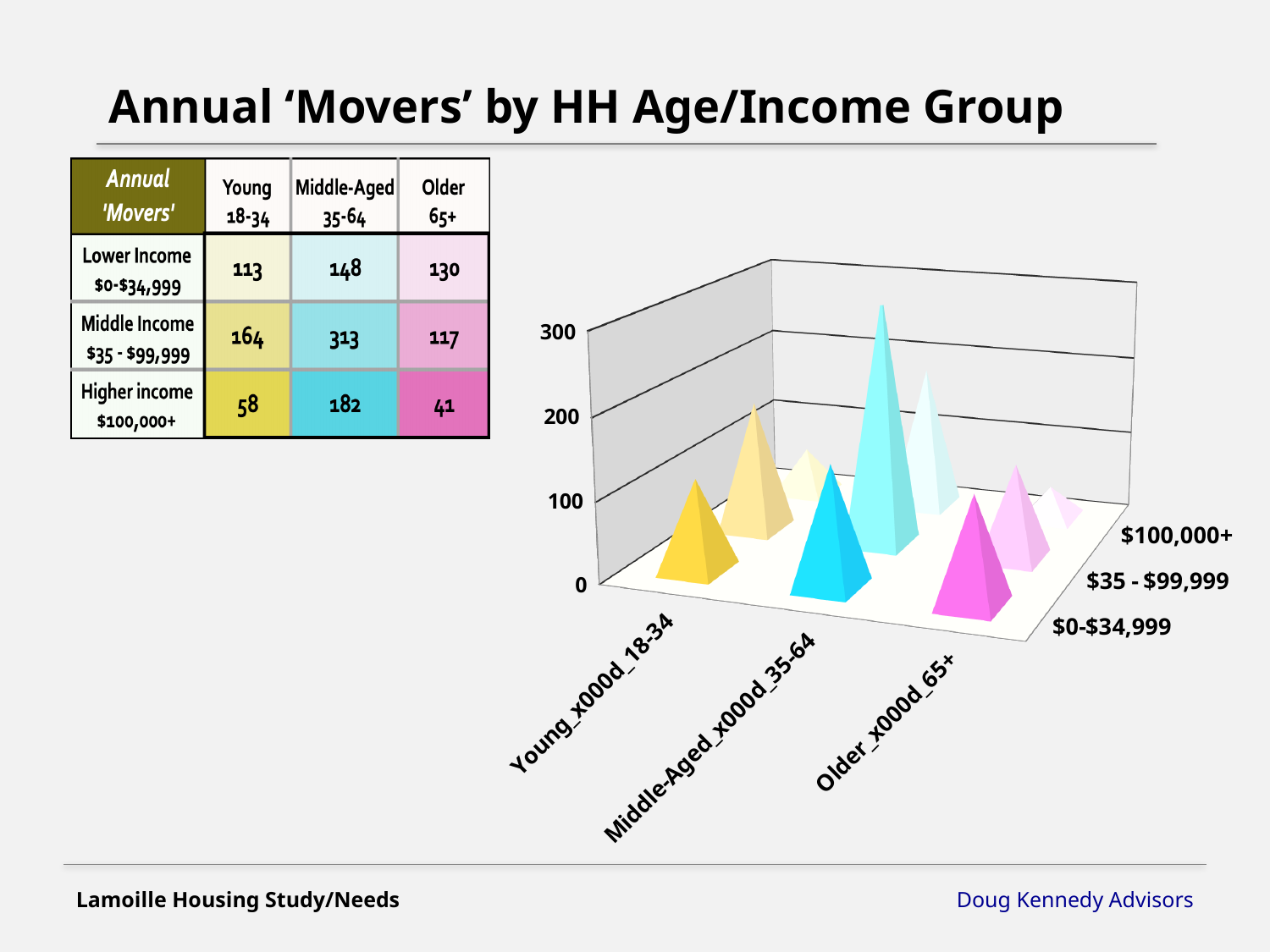
In the chart, which age group and income group combination has the shortest pyramid? Older 65+, $100,000+ How many income groups (series) are plotted in the chart? 3 Is the value for Middle-Aged 35-64 households in the $35 - $99,999 income group greater or less than 300? greater In the chart, which age group and income group combination has the tallest pyramid? Middle-Aged 35-64, $35 - $99,999 What is the number of annual movers for Young 18-34 households in the $0-$34,999 income group? 113 What is the number of annual movers for Middle-Aged 35-64 households in the $35 - $99,999 income group? 313 Which has more annual movers: Young 18-34 households in the $35 - $99,999 group or Older 65+ households in the $0-$34,999 group? Young 18-34 in $35 - $99,999 What kind of chart is shown on the slide? 3D bar chart (pyramid-shaped bars) What is the total number of annual movers for Middle-Aged 35-64 households across all three income groups? 643 Is the value for Older 65+ households in the $100,000+ income group greater or less than 100? less What is the difference in annual movers between Middle-Aged 35-64 and Young 18-34 households in the $100,000+ income group? 124 How many age groups are shown along the x axis of the chart? 3